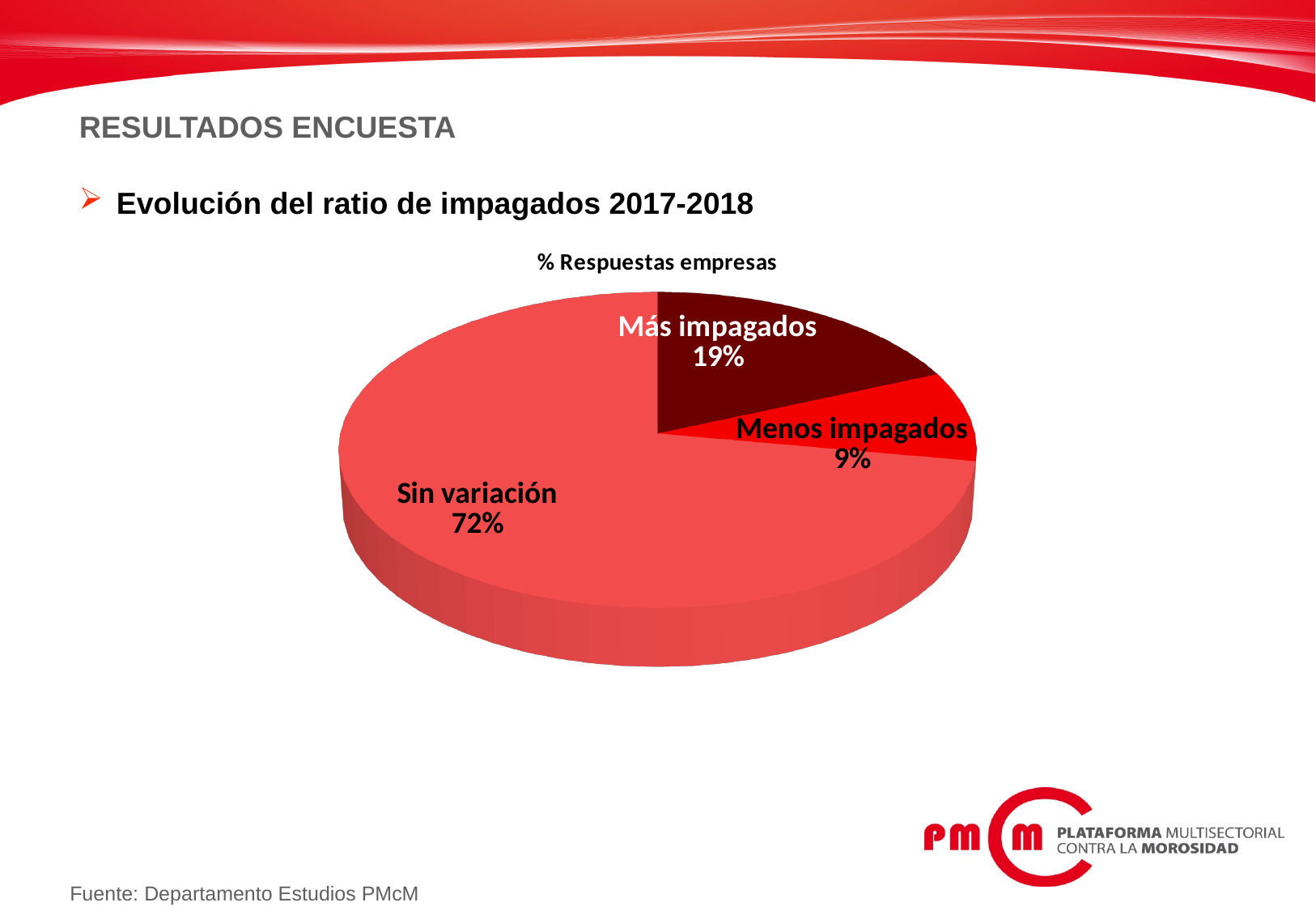
Which category has the smallest share of the pie? Menos impagados What percentage of responses is labelled 'Sin variación'? 72% What is the title of the chart? % Respuestas empresas What percentage of responses is labelled 'Menos impagados'? 9% What is the difference in percentage points between 'Sin variación' and 'Más impagados'? 53 Which is larger, the share for 'Más impagados' or the share for 'Menos impagados'? Más impagados What type of chart is shown on the slide? Pie chart How many slices does the pie chart have? 3 Which category has the largest share of the pie? Sin variación What is the difference in percentage points between 'Más impagados' and 'Menos impagados'? 10 What share of the pie does the 'Sin variación' slice represent? 72% What percentage of responses is labelled 'Más impagados'? 19%